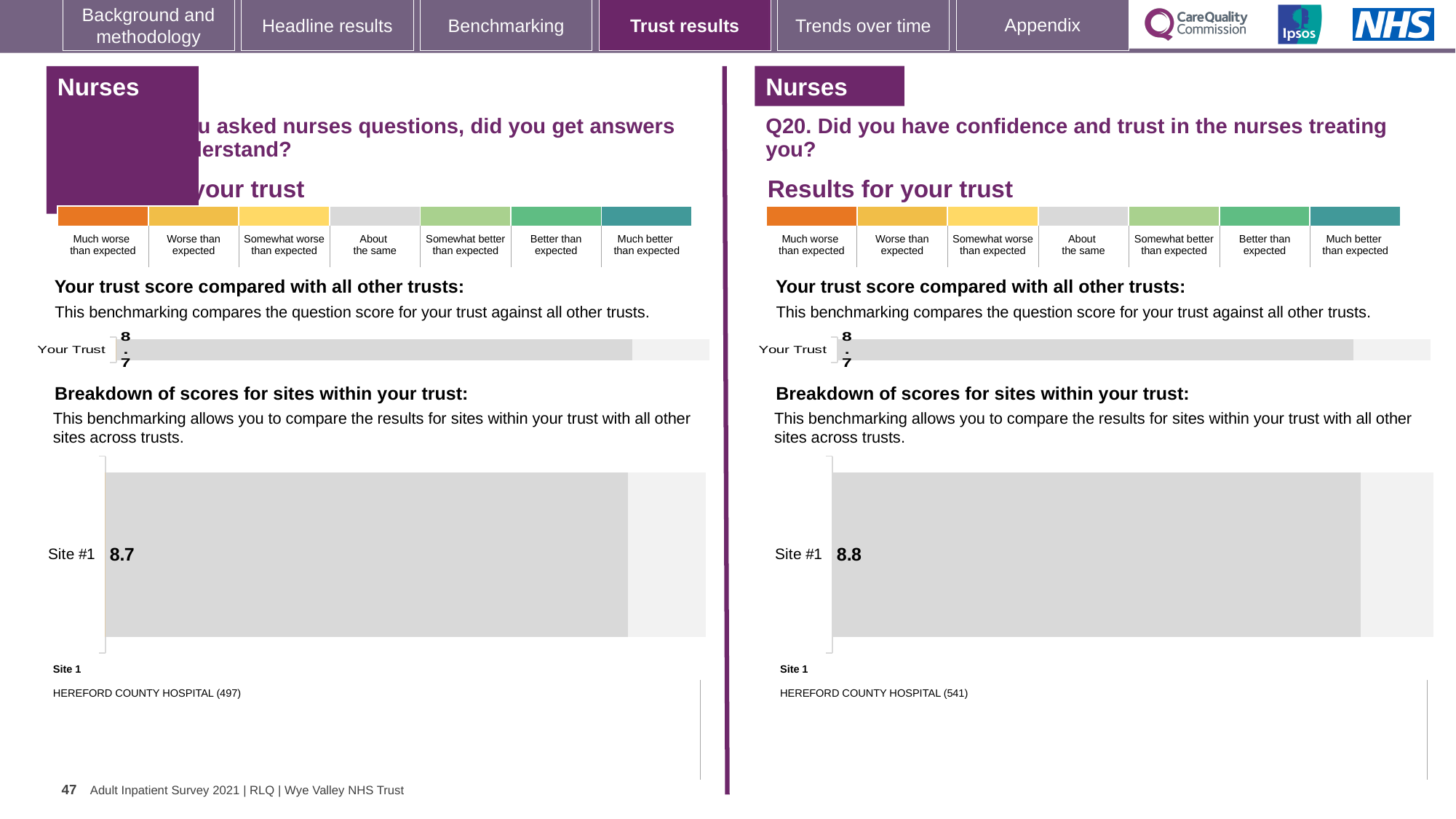
What type of chart is used to show the Site #1 score on each panel? Bar chart Which hospital is listed as Site 1 on the left-hand panel? HEREFORD COUNTY HOSPITAL (497) Which panel shows the higher Site #1 score, the left-hand panel or the right-hand panel (Q20)? Right-hand panel (Q20) On the right-hand panel (Q20), what is the difference between the Site #1 score and the Your Trust score? 0.1 Which hospital is listed as Site 1 on the right-hand panel (Q20)? HEREFORD COUNTY HOSPITAL (541) On the left-hand panel, what is the score shown for Your Trust? 8.7 On the left-hand panel, what is the score shown for Site #1? 8.7 On the right-hand panel (Q20), what is the score shown for Site #1? 8.8 Which is larger on the right-hand panel (Q20): the Site #1 score or the Your Trust score? Site #1 How many sites are shown in the breakdown of scores on the right-hand panel (Q20)? 1 On the right-hand panel (Q20), what is the score shown for Your Trust? 8.7